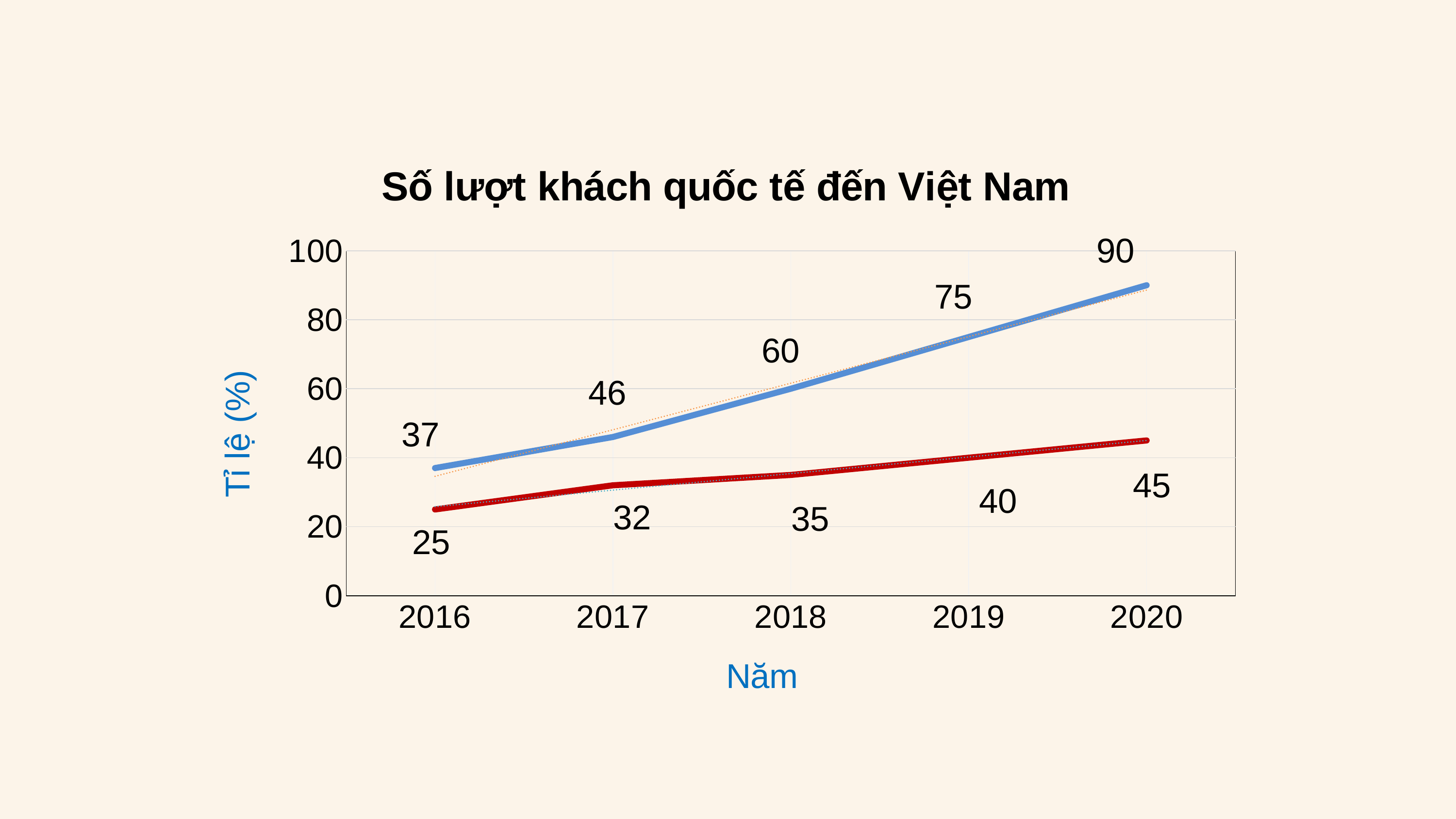
Which is larger in 2016, the blue line value or the red line value? blue line What is the difference between the blue line and the red line in 2019? 35 In which year does the blue line reach its highest value? 2020 What kind of chart is shown on the slide? line chart What is the label of the y axis? Tỉ lệ (%) What is the value of the blue line in 2020? 90 What is the value of the red line in 2017? 32 What is the value of the blue line in 2018? 60 In which year does the red line reach its lowest value? 2016 What is the title of the chart? Số lượt khách quốc tế đến Việt Nam How many years are plotted along the x axis? 5 Does the red line rise or fall from 2016 to 2020? rise